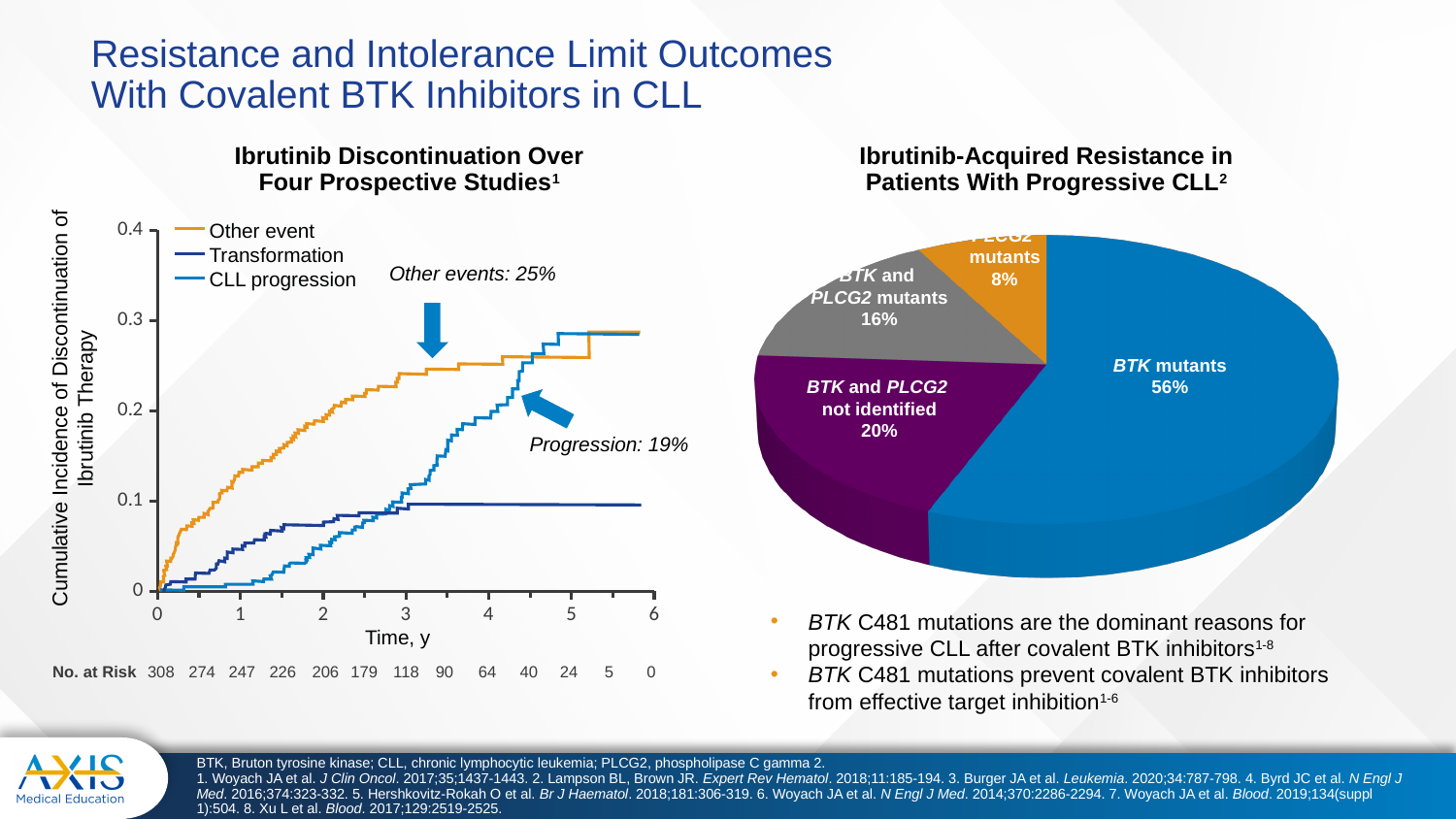
In the pie chart on the right, which category has the smallest share? PLCG2 mutants In the pie chart 'Ibrutinib-Acquired Resistance in Patients With Progressive CLL', what percentage of patients have PLCG2 mutants? 8% In the chart 'Ibrutinib Discontinuation Over Four Prospective Studies', does the 'Other event' curve rise or fall over time? Rises In the pie chart on the right, what is the difference between the share for BTK mutants and the share for PLCG2 mutants? 48 percentage points In the pie chart on the right, how many slices are there? 4 In the chart 'Ibrutinib Discontinuation Over Four Prospective Studies', what is the number at risk at time 0? 308 What kind of chart is 'Ibrutinib-Acquired Resistance in Patients With Progressive CLL'? Pie chart In the pie chart on the right, which category has the largest share? BTK mutants In the pie chart 'Ibrutinib-Acquired Resistance in Patients With Progressive CLL', what percentage of patients have BTK mutants? 56% What kind of chart is 'Ibrutinib Discontinuation Over Four Prospective Studies'? Line chart In the chart 'Ibrutinib Discontinuation Over Four Prospective Studies', is the 'Other event' curve at 6 years greater or less than 0.2? greater In the chart 'Ibrutinib Discontinuation Over Four Prospective Studies', how many series does the legend list? 3